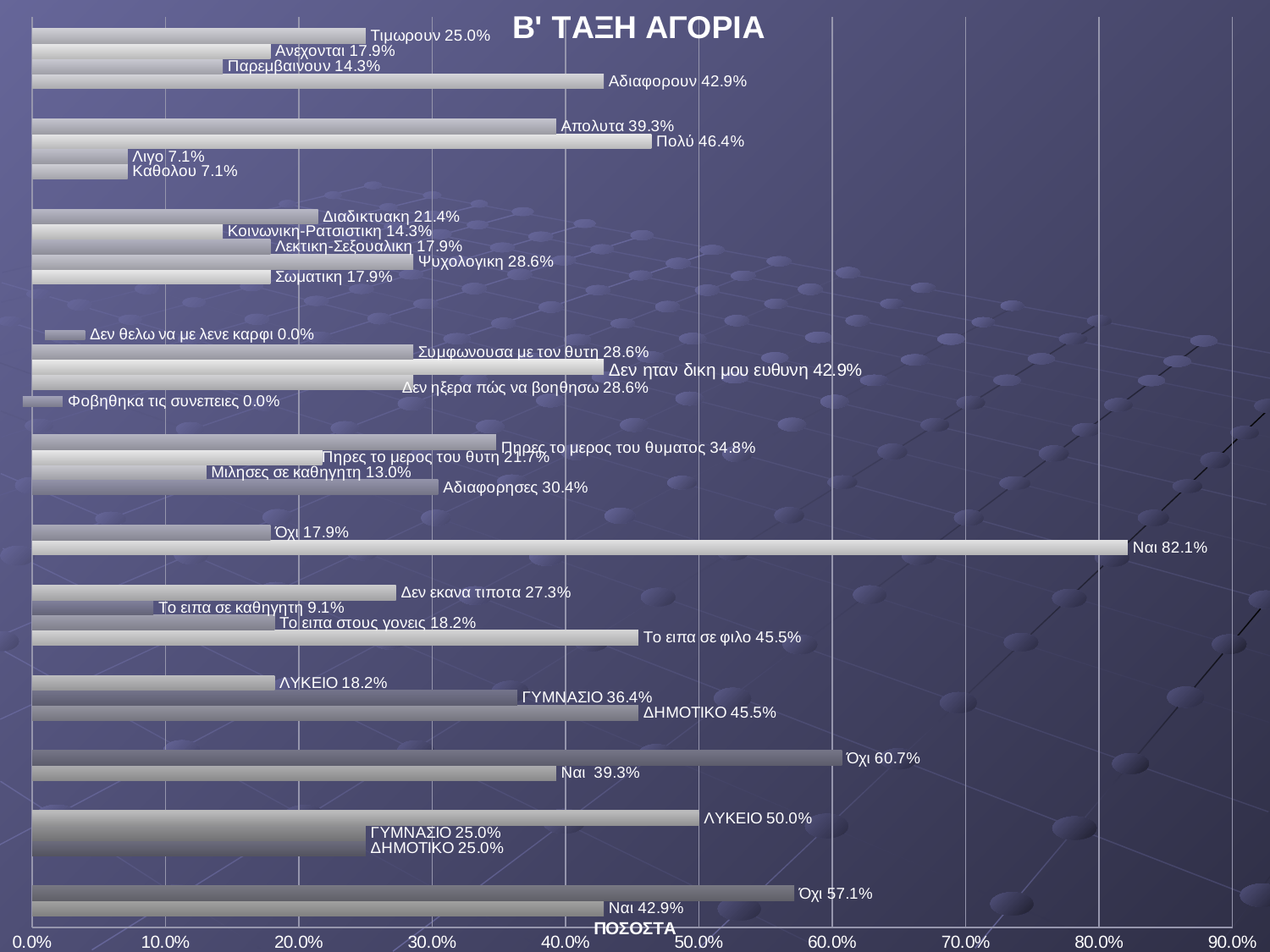
Which is larger, Διαδικτυακη or Σωματικη? Διαδικτυακη What is the value for Αδιαφορουν? 42.9% What is the label of the horizontal axis? ΠΟΣΟΣΤΑ What is the difference between Πηρες το μερος του θυματος and Πηρες το μερος του θυτη? 13.1% What type of chart is shown on the slide? bar chart What is the title of the chart? Β' ΤΑΞΗ ΑΓΟΡΙΑ What is the value for Πολύ? 46.4% What is the value for Το ειπα σε φιλο? 45.5% Which bar has the highest value on the whole chart? Ναι 82.1% What is the value for Δεν εκανα τιποτα? 27.3% What is the difference between Δεν ηταν δικη μου ευθυνη and Συμφωνουσα με τον θυτη? 14.3% What is the value for Ψυχολογικη? 28.6%